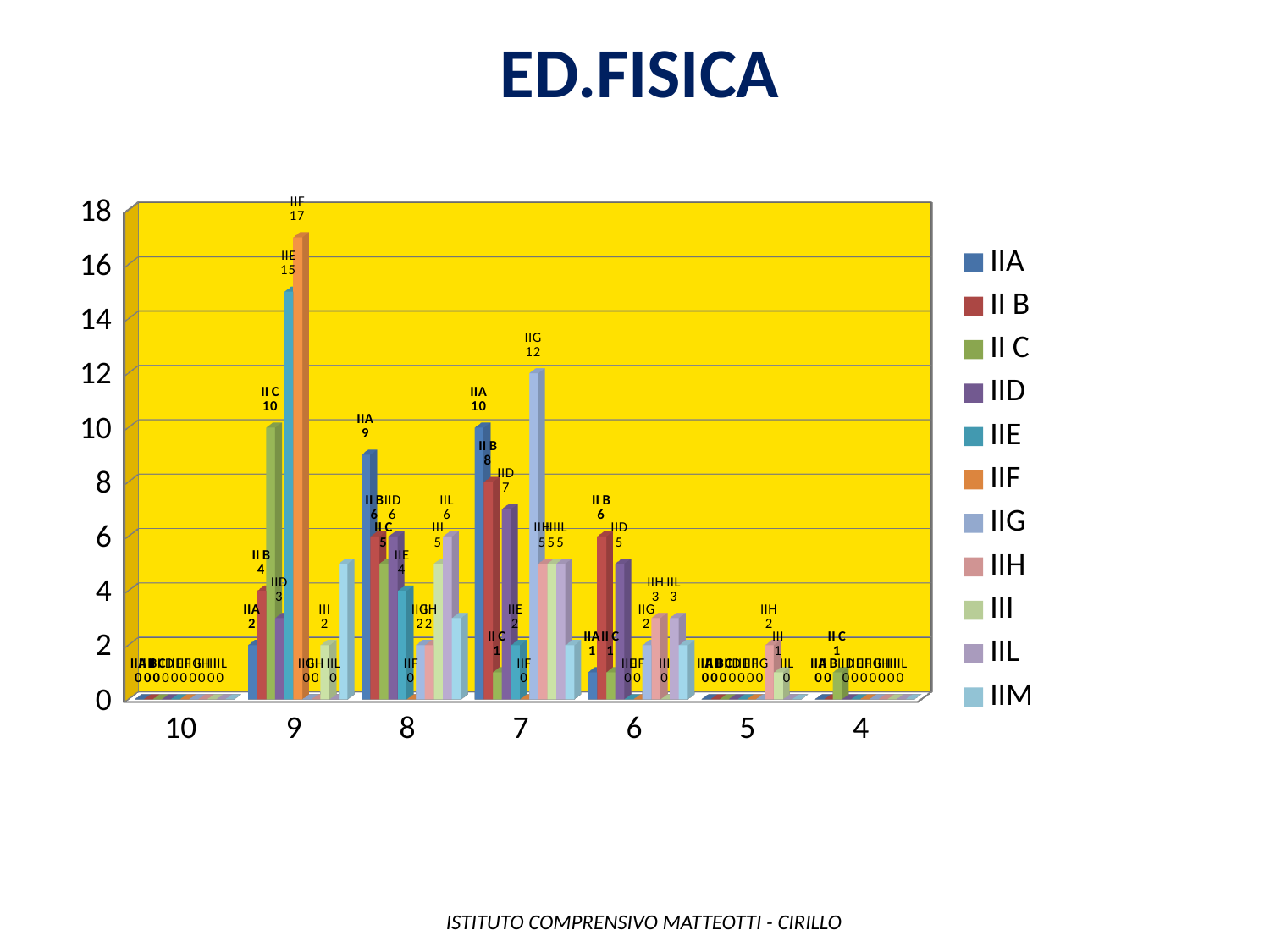
Which series has the highest value at grade 9? IIF How many grade categories are shown on the x axis? 7 How many series does the legend list? 11 What is the value for IIG at grade 7? 12 What is the value for IIE at grade 9? 15 What kind of chart is shown on the slide? Bar chart What is the value for II C at grade 9? 10 What is the difference between the IIF and IIE values at grade 9? 2 At grade 7, which is larger: the value for IIA or the value for II B? IIA What is the value for IIA at grade 8? 9 Which series has the highest value at grade 7? IIG What is the value for IIF at grade 9? 17